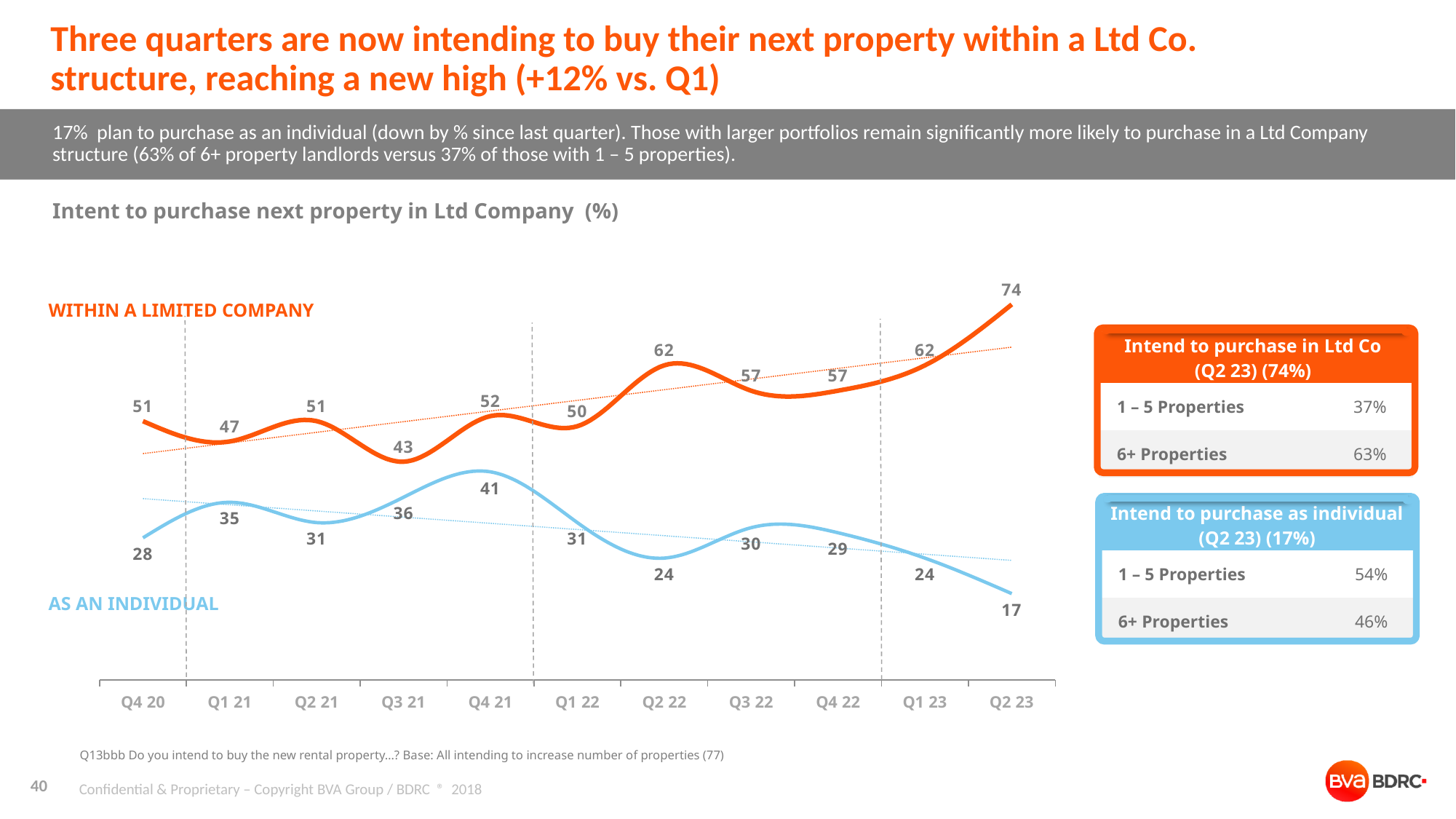
What is the value for 'Within a limited company' in Q2 23? 74 How many series are plotted on the chart? 2 Which is larger in Q4 21: the 'Within a limited company' value or the 'As an individual' value? Within a limited company Does the 'As an individual' line rise or fall from Q3 22 to Q2 23? fall How many quarters are plotted on the x axis? 11 What is the difference between the 'Within a limited company' and 'As an individual' values in Q2 23? 57 What is the value for 'Within a limited company' in Q3 21? 43 What is the value for 'As an individual' in Q4 21? 41 By how much did the 'Within a limited company' value change from Q1 23 to Q2 23? 12 In which quarter is the 'As an individual' line at its lowest? Q2 23 In which quarter is the 'Within a limited company' line at its highest? Q2 23 What kind of chart is shown on the slide? line chart